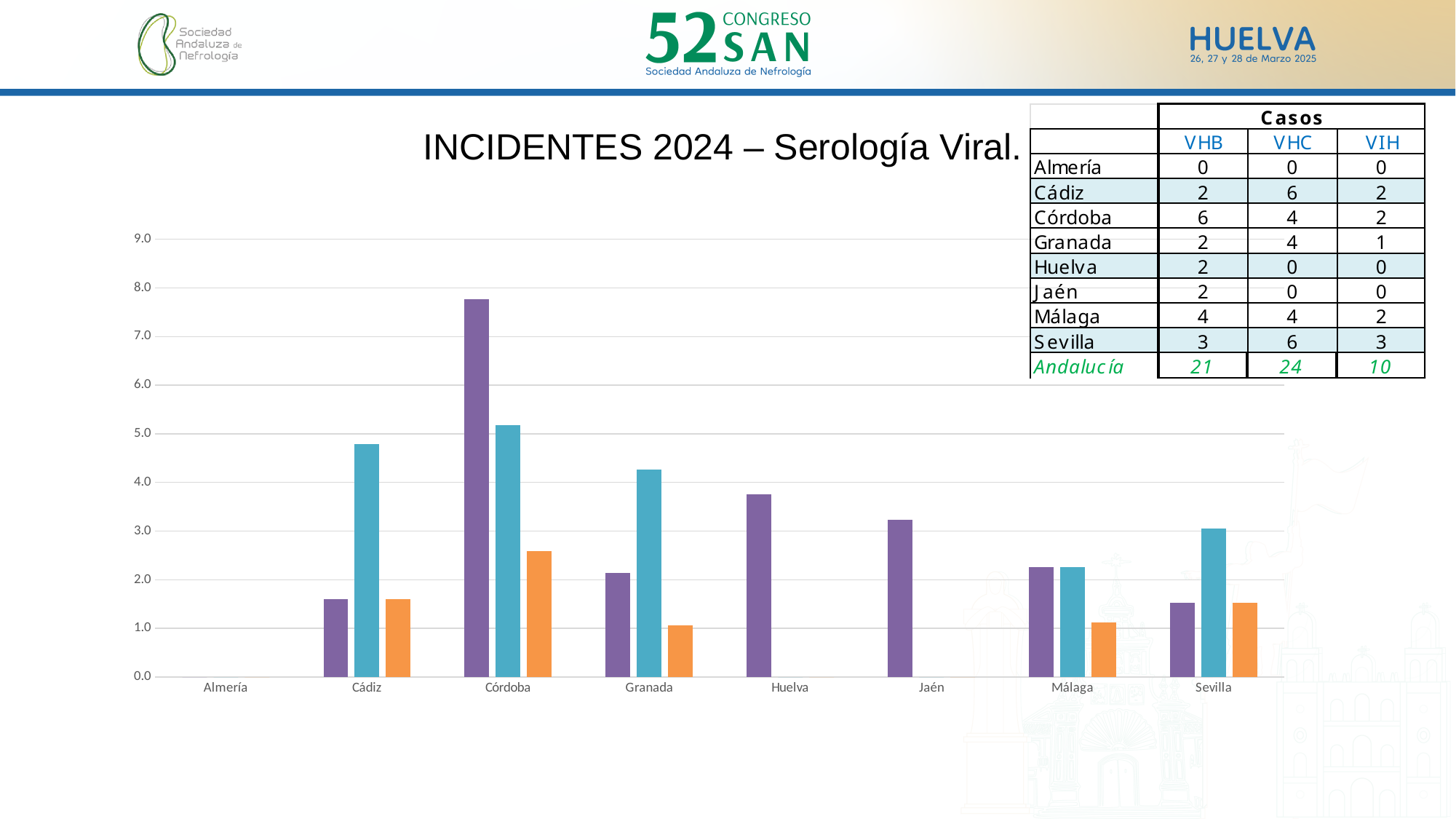
Which category has the tallest bar in the chart? Córdoba Which is larger for Cádiz, the purple bar or the teal bar? teal bar What kind of chart is shown on the slide? bar chart Is the purple bar for Huelva greater or less than 3.0? greater How many categories (provinces) are shown on the x axis of the chart? 8 What is the title of the chart? INCIDENTES 2024 – Serología Viral. Is the orange bar for Córdoba greater or less than 2.0? greater Is the teal bar for Cádiz greater or less than 4.0? greater Which category has the tallest orange bar? Córdoba Which category has the tallest teal bar? Córdoba Which category shows no bars at all in the chart? Almería